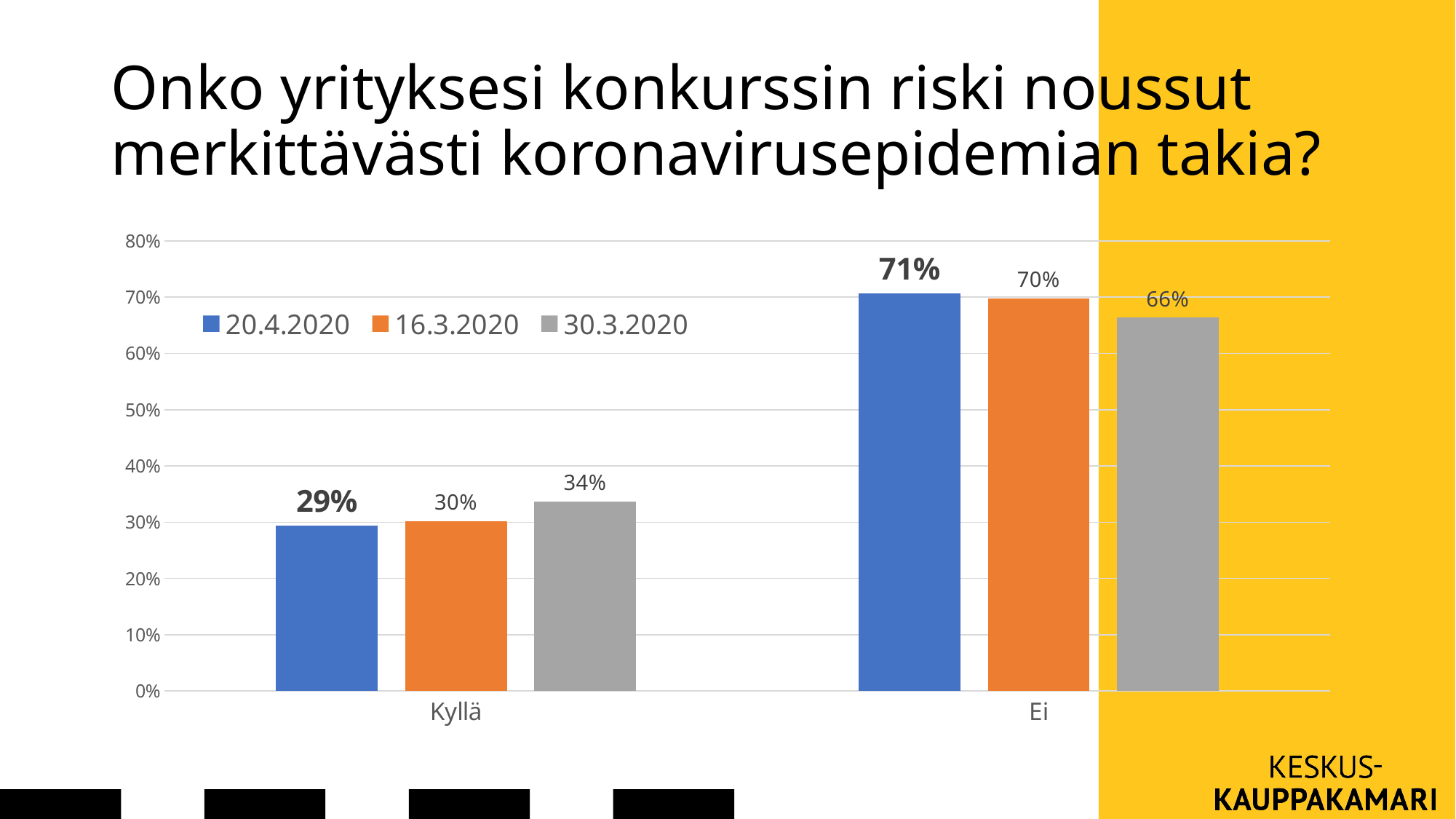
Which is larger: the 20.4.2020 value for Ei or the 30.3.2020 value for Ei? 20.4.2020 Which series has the highest value for Kyllä? 30.3.2020 What is the difference between the Ei and Kyllä values in the 20.4.2020 series? 42% What is the value for Kyllä in the 20.4.2020 series? 29% What is the value for Kyllä in the 16.3.2020 series? 30% What kind of chart is shown on the slide? bar chart How many series does the legend list? 3 How many categories are shown on the x axis? 2 Which series has the lowest value for Ei? 30.3.2020 What is the difference between the 30.3.2020 and 20.4.2020 values for Kyllä? 5% What is the value for Ei in the 30.3.2020 series? 66% What is the value for Ei in the 16.3.2020 series? 70%